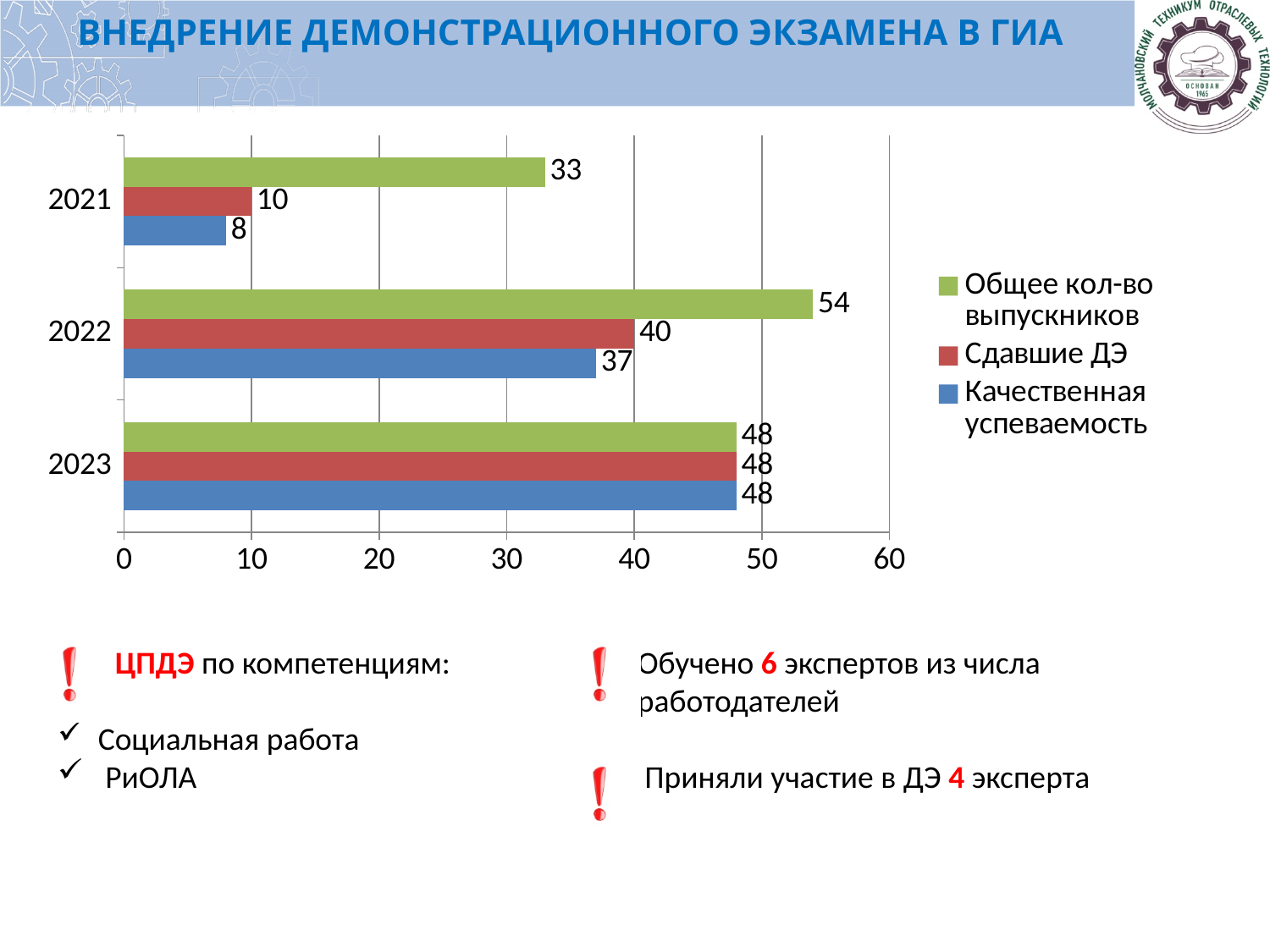
How many series does the legend list? 3 Which year has the lowest value for "Качественная успеваемость"? 2021 Is the value of "Качественная успеваемость" for 2022 greater or less than 30? greater What is the value of "Общее кол-во выпускников" for 2022? 54 Which year has the highest value for "Общее кол-во выпускников"? 2022 What is the value of "Сдавшие ДЭ" for 2021? 10 What is the difference between "Общее кол-во выпускников" and "Сдавшие ДЭ" in 2022? 14 What is the value of "Качественная успеваемость" for 2023? 48 What colour represents "Сдавшие ДЭ" in the chart? red What kind of chart is shown on the slide? bar chart How many years are shown on the chart? 3 Which is larger: "Сдавшие ДЭ" in 2022 or "Сдавшие ДЭ" in 2023? 2023